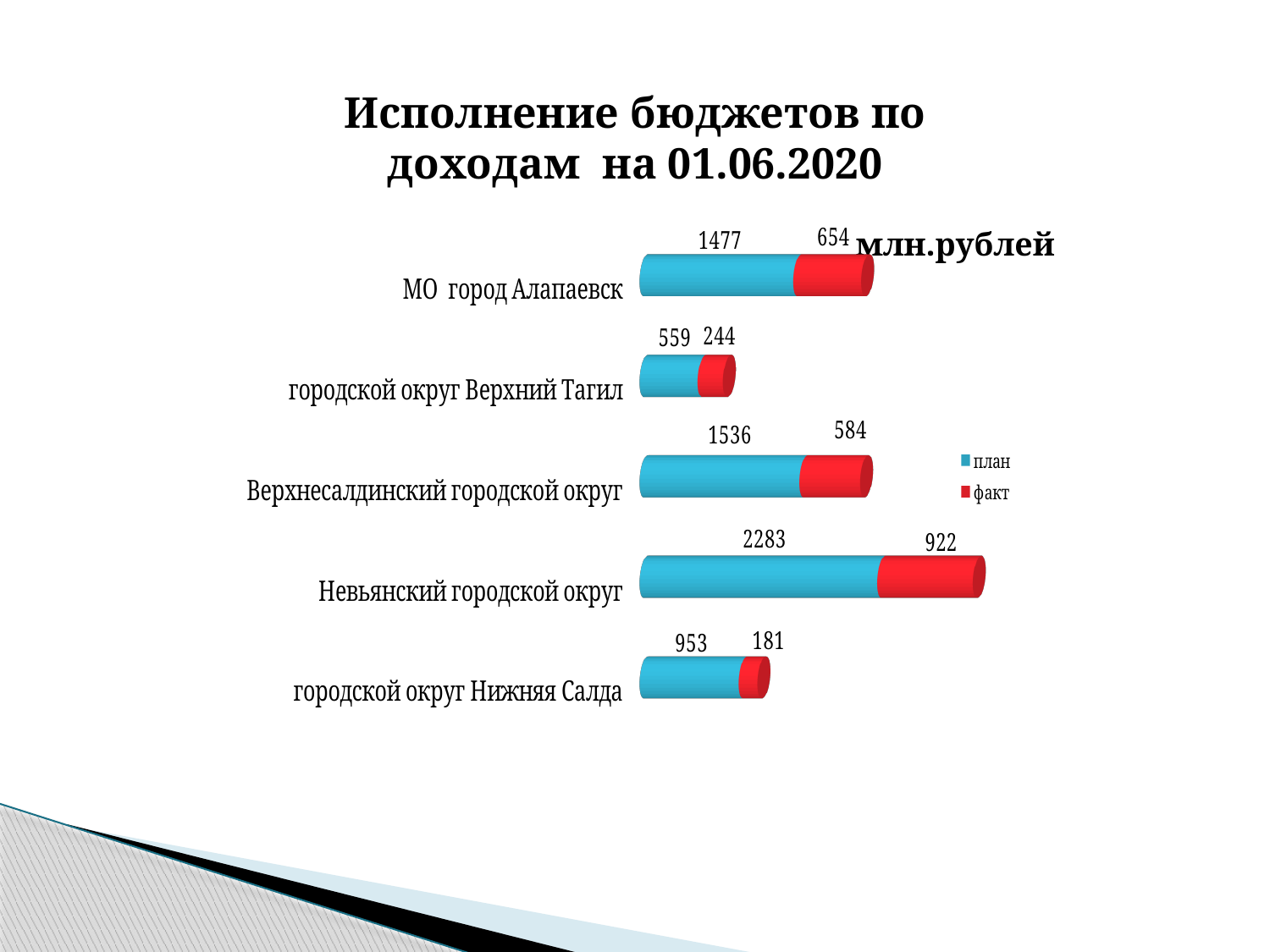
What is the difference between the план and факт values for Верхнесалдинский городской округ? 952 Which is larger, the факт value for МО город Алапаевск or the факт value for Верхнесалдинский городской округ? МО город Алапаевск What kind of chart is shown on the slide? bar chart What is the факт value for МО город Алапаевск? 654 Which category has the lowest факт value? городской округ Нижняя Салда How many categories are shown in the chart? 5 What is the total of the stacked bar for Невьянский городской округ? 3205 What is the план value for Невьянский городской округ? 2283 What is the факт value for городской округ Верхний Тагил? 244 How many series does the legend list? 2 What is the план value for городской округ Нижняя Салда? 953 Which category has the highest план value? Невьянский городской округ